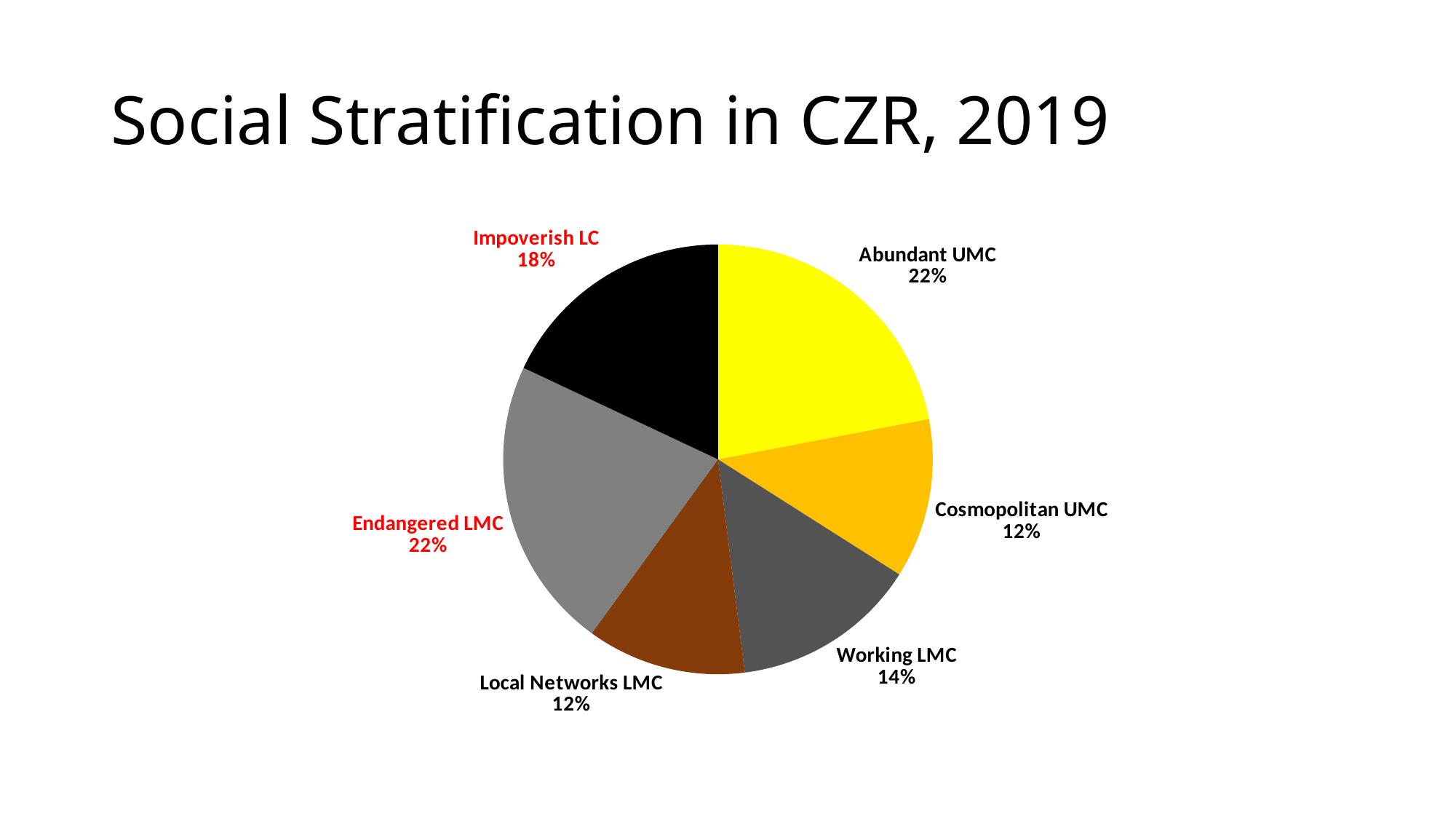
What is the title of the chart on the slide? Social Stratification in CZR, 2019 What is the value shown for Local Networks LMC? 12% Which is larger, Cosmopolitan UMC or Abundant UMC? Abundant UMC What is the value shown for Cosmopolitan UMC? 12% What share of the pie is Working LMC? 14% What is the value shown for Endangered LMC? 22% What share of the pie is Impoverish LC? 18% What kind of chart is shown on the slide? pie chart What is the difference between the shares of Abundant UMC and Working LMC? 8% How many slices does the pie chart have? 6 Which slice of the pie is coloured black? Impoverish LC Which is larger, Impoverish LC or Working LMC? Impoverish LC